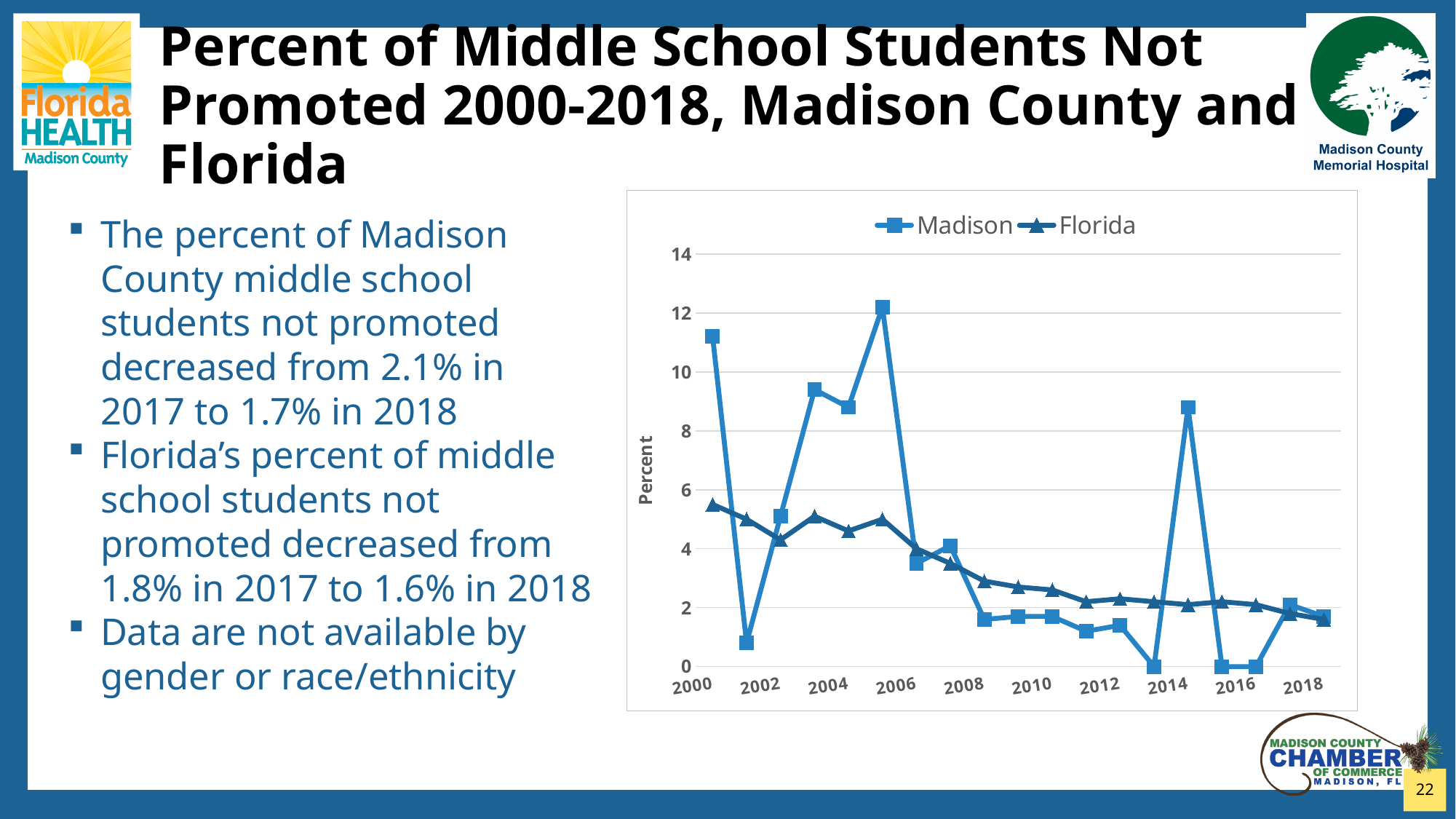
In which year does the Madison series reach its highest value? 2005 What was the percent of Madison County middle school students not promoted in 2018? 1.7% Is the value for Madison in 2000 greater or less than 10? greater Which two series are shown in the chart legend? Madison and Florida Is the value for Madison in 2001 greater or less than 2? less Does the Florida series generally rise or fall from 2000 to 2018? fall What kind of chart is shown on the slide? line chart Which series has the larger value in 2001, Madison or Florida? Florida In which year does the Florida series reach its highest value? 2000 How many series does the chart legend list? 2 Is the value for Madison in 2014 greater or less than 8? greater What is the label on the vertical axis of the chart? Percent